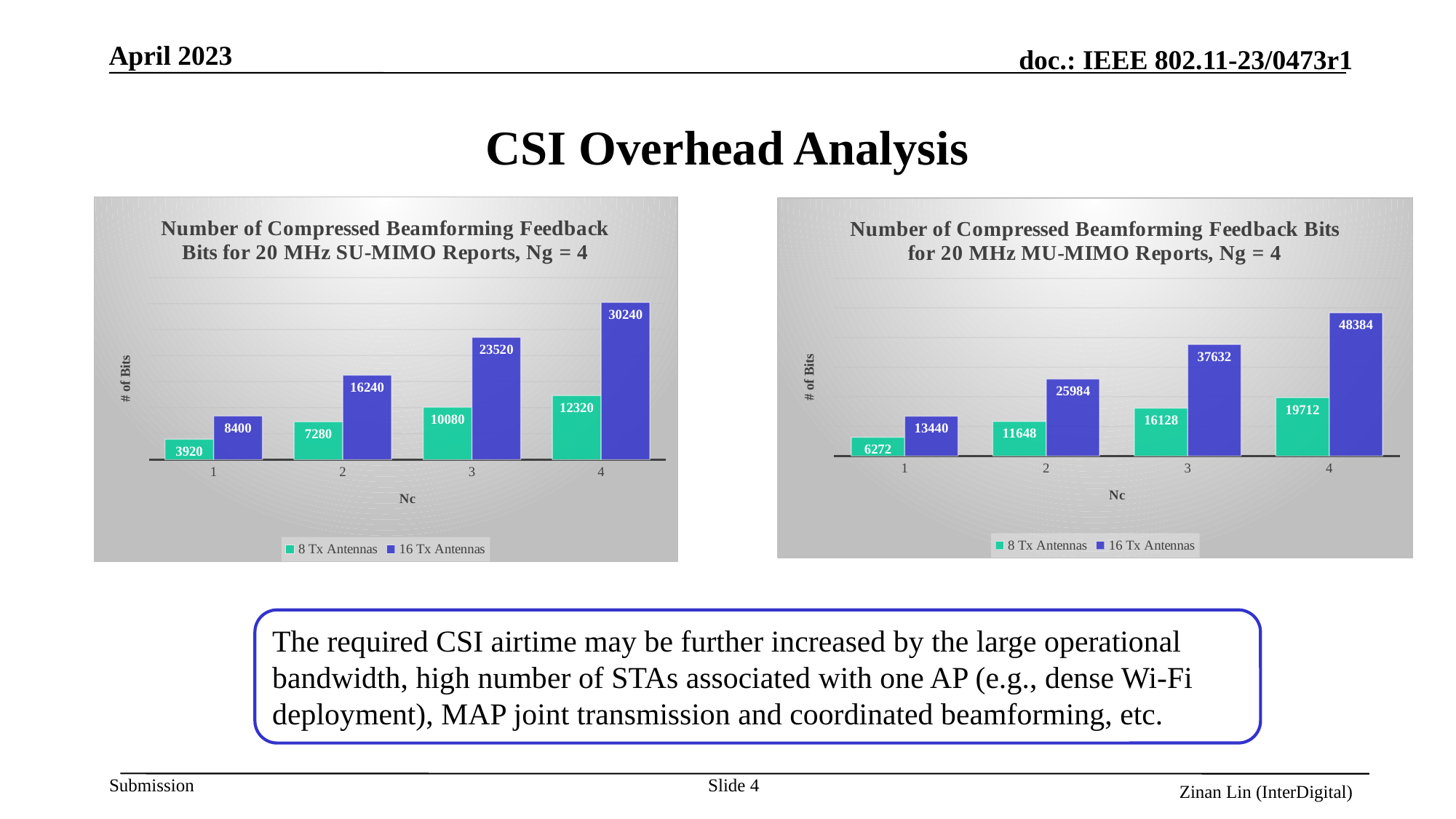
In the MU-MIMO chart (right), which is larger at Nc = 2: 8 Tx Antennas or 16 Tx Antennas? 16 Tx Antennas What type of chart is the SU-MIMO chart (left)? Bar chart In the SU-MIMO chart (left), what is the value for 16 Tx Antennas at Nc = 4? 30240 How many Nc categories are shown on the x axis of the SU-MIMO chart (left)? 4 How many series does the legend of the MU-MIMO chart (right) list? 2 In the SU-MIMO chart (left), which Nc value has the highest number of bits for 16 Tx Antennas? 4 In the SU-MIMO chart (left), what is the value for 8 Tx Antennas at Nc = 1? 3920 In the MU-MIMO chart (right), which Nc value has the lowest number of bits for 8 Tx Antennas? 1 In the MU-MIMO chart (right), what is the value for 16 Tx Antennas at Nc = 2? 25984 In the MU-MIMO chart (right), what is the difference between the 16 Tx Antennas and 8 Tx Antennas values at Nc = 4? 28672 In the SU-MIMO chart (left), what is the difference between the 16 Tx Antennas and 8 Tx Antennas values at Nc = 3? 13440 In the MU-MIMO chart (right), what is the value for 8 Tx Antennas at Nc = 3? 16128